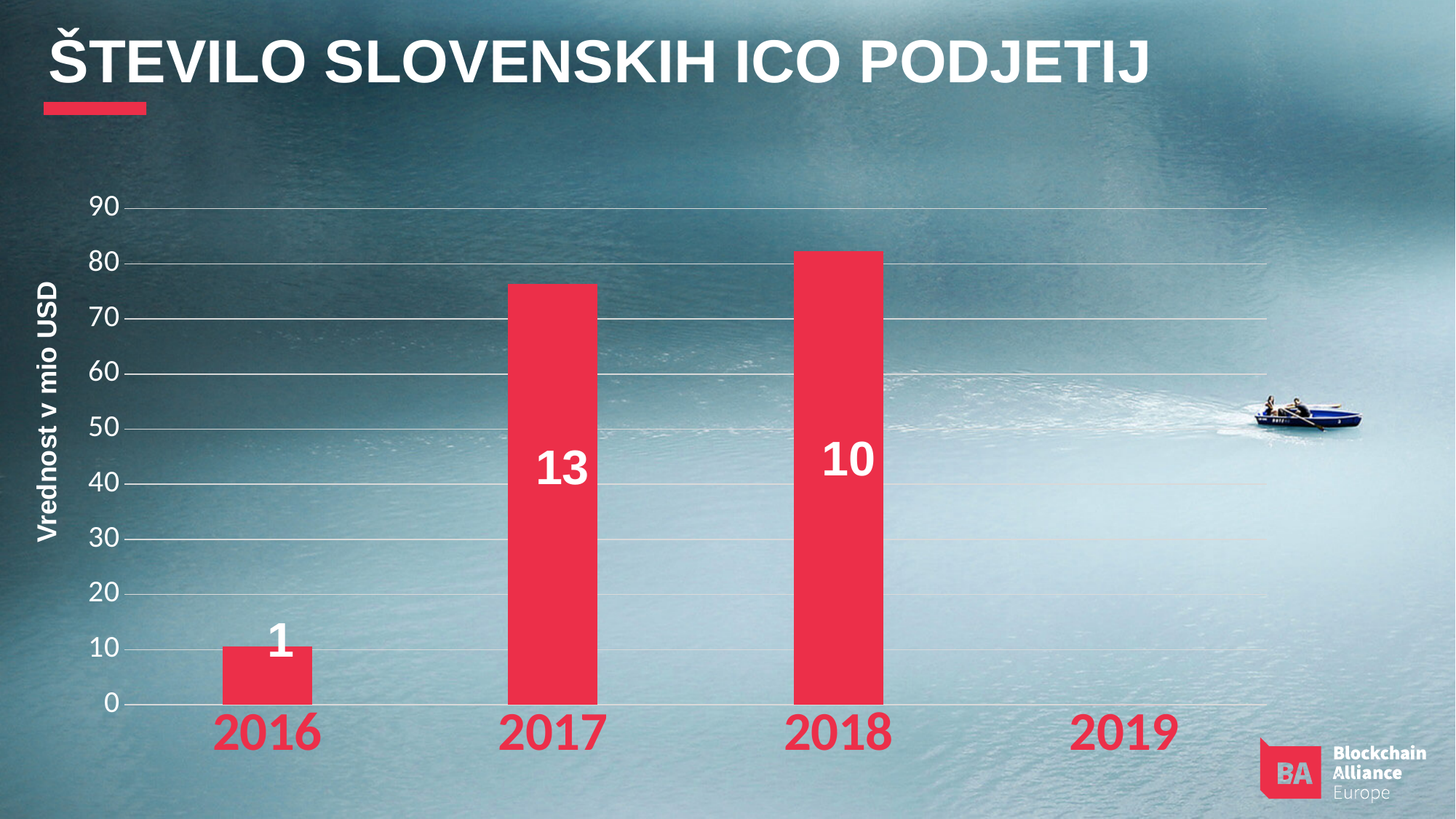
Is the bar for 2018 greater or less than 80 on the y axis? greater What is the label on the y axis? Vrednost v mio USD Which year has the tallest bar? 2018 How many years are labelled on the x axis? 4 Which year with a bar has the shortest bar? 2016 Is the bar for 2017 greater or less than 70 on the y axis? greater What is the difference between the numbers printed on the 2017 and 2018 bars? 3 Which bar is taller, 2017 or 2018? 2018 What number is printed on the bar for 2017? 13 Is the bar for 2016 greater or less than 20 on the y axis? less What number is printed on the bar for 2016? 1 What number is printed on the bar for 2018? 10